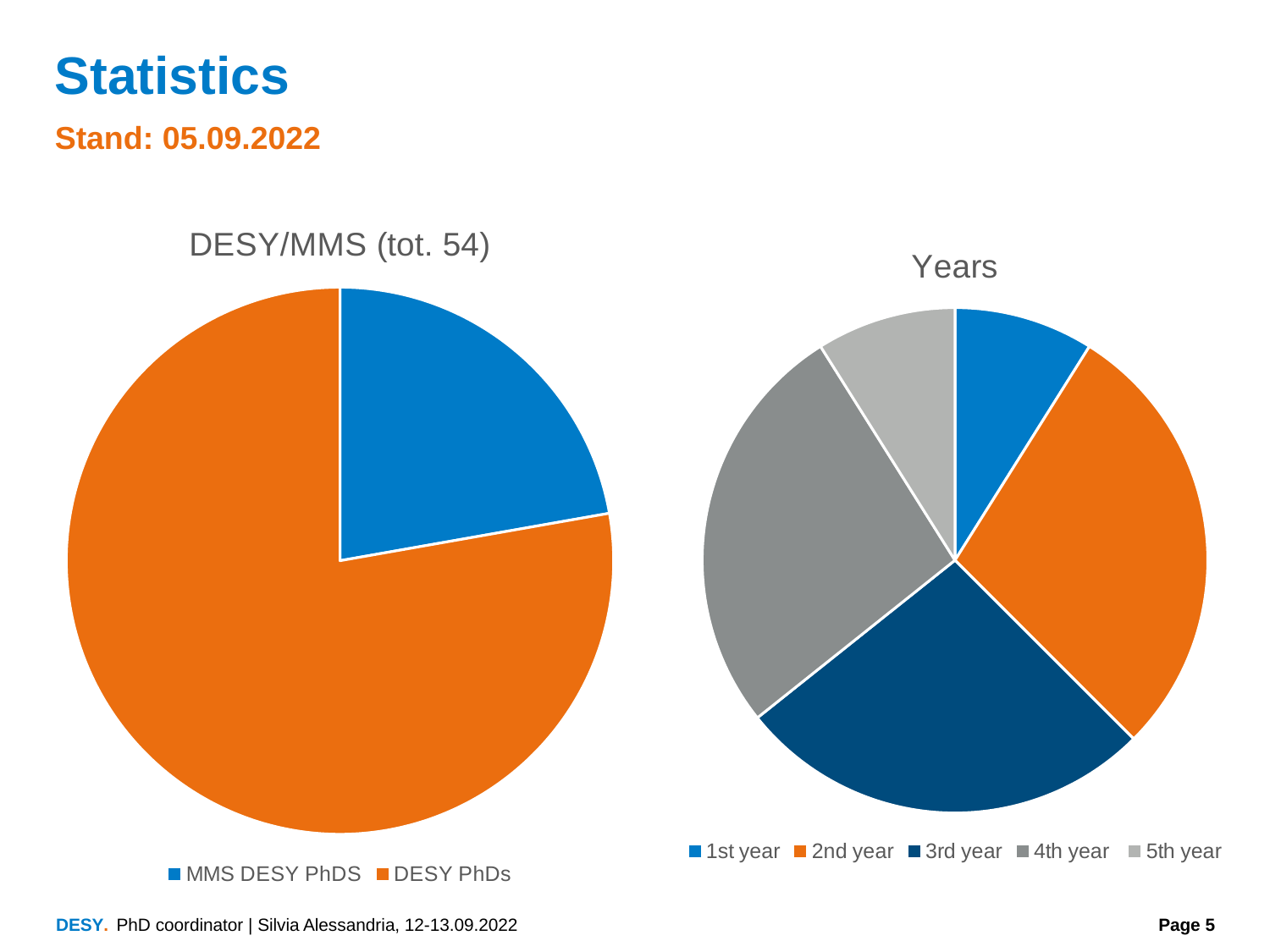
In the Years chart, which is larger: 1st year or 2nd year? 2nd year What kind of chart is the Years chart on the right? pie chart What colour is the 2nd year slice in the Years chart? orange How many entries does the legend of the Years chart list? 5 In the Years chart, which is larger: 3rd year or 5th year? 3rd year In the DESY/MMS (tot. 54) chart, which category has the smallest slice? MMS DESY PhDS In the DESY/MMS (tot. 54) chart, which is larger: MMS DESY PhDS or DESY PhDs? DESY PhDs How many slices does the Years chart have? 5 What total is given in the title of the left pie chart? 54 How many slices does the DESY/MMS (tot. 54) chart have? 2 What kind of chart is the DESY/MMS (tot. 54) chart on the left? pie chart In the DESY/MMS (tot. 54) chart, which category has the largest slice? DESY PhDs